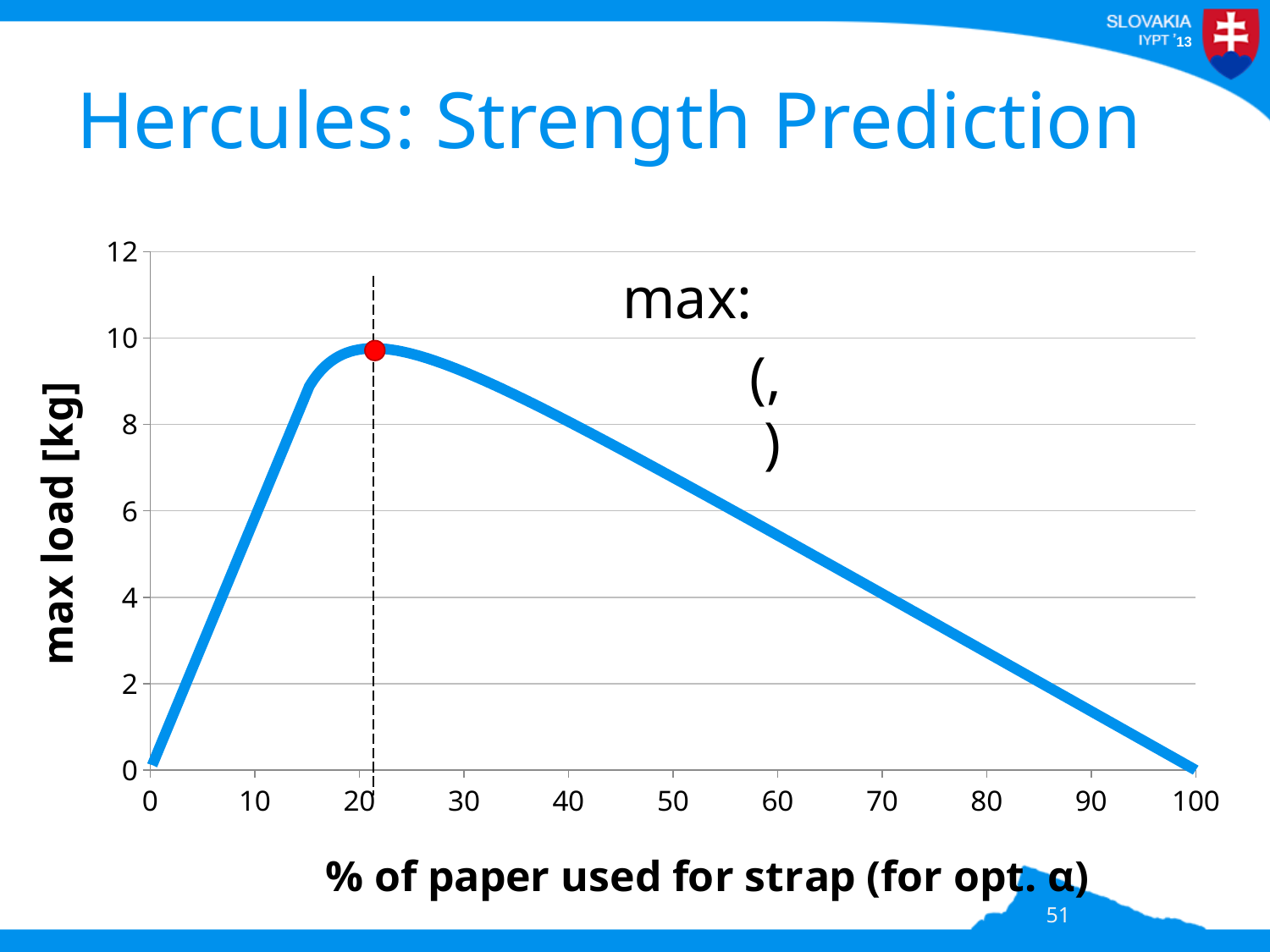
What is the max load when 100% of paper is used for the strap? 0 What is the label of the y axis? max load [kg] What is the label of the x axis? % of paper used for strap (for opt. α) What is the max load when 0% of paper is used for the strap? 0 Do the max load values rise or fall as the % of paper used for strap increases from 30 to 100? fall Is the max load at 80% of paper used for strap greater or less than 4? less Is the max load at 50% of paper used for strap greater or less than 6? greater Is the max load at 30% of paper used for strap greater or less than 8? greater Which is larger, the max load at 40% or at 90% of paper used for strap? 40% What kind of chart is shown on the slide? line chart